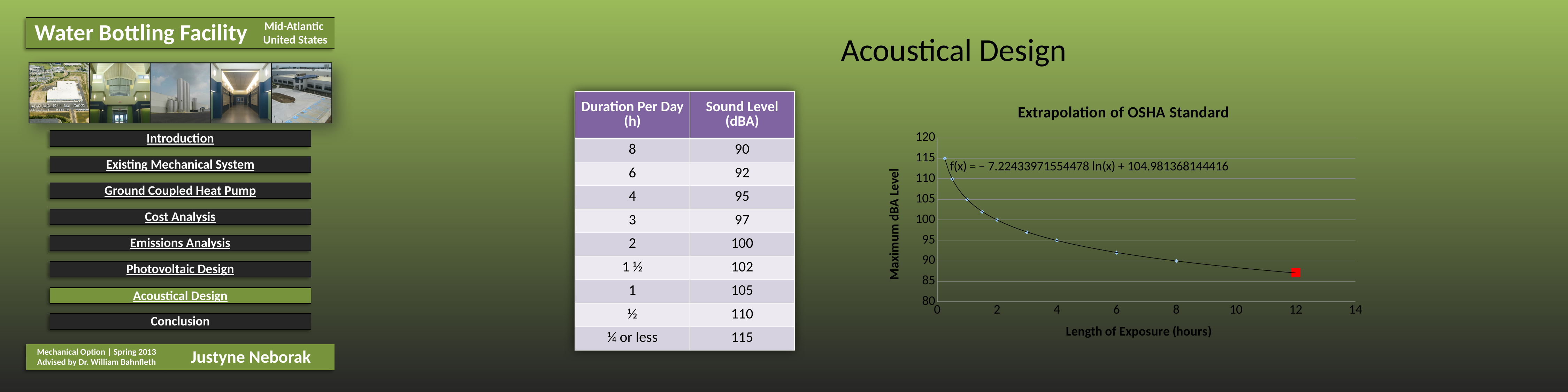
In the chart, what is the maximum dBA level plotted at a length of exposure of 1 hour? 105 In the chart, is the maximum dBA level at 6 hours greater or less than 90? greater In the chart, what is the maximum dBA level plotted at a length of exposure of 8 hours? 90 What is the title of the chart on the slide? Extrapolation of OSHA Standard In the chart, what is the maximum dBA level plotted at a length of exposure of 2 hours? 100 In the chart, does the maximum dBA level rise or fall as the length of exposure increases? fall In the chart, what is the maximum dBA level plotted at a length of exposure of 4 hours? 95 In the chart, which has the higher maximum dBA level: the point at 1 hour or the point at 8 hours? 1 hour What kind of chart is shown under the title 'Extrapolation of OSHA Standard'? scatter chart In the chart, is the value of the red point at 12 hours greater or less than 90? less What is the label of the x axis of the chart? Length of Exposure (hours) In the chart, is the value of the red point at 12 hours greater or less than 85? greater